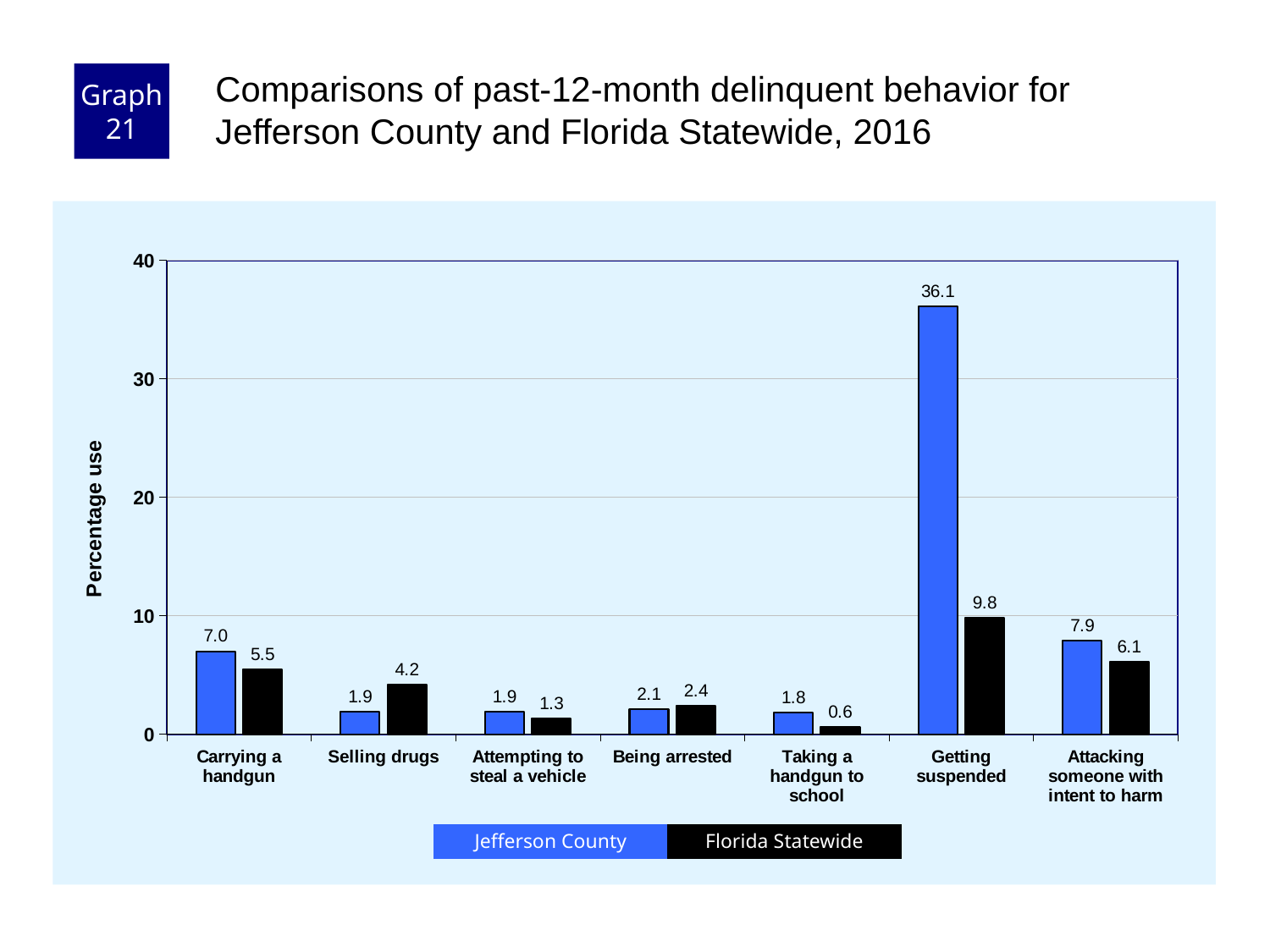
What is the Florida Statewide value for Taking a handgun to school? 0.6 What is the Jefferson County value for Getting suspended? 36.1 How many series does the legend list? 2 What is the Jefferson County value for Attacking someone with intent to harm? 7.9 How many categories are shown on the x axis? 7 Which category has the lowest Jefferson County value? Taking a handgun to school Which is larger for Selling drugs: the Jefferson County value or the Florida Statewide value? Florida Statewide What kind of chart is shown on the slide? bar chart Is the Jefferson County value for Getting suspended greater or less than 30? greater What is the difference between the Jefferson County and Florida Statewide values for Getting suspended? 26.3 Which category has the highest Florida Statewide value? Getting suspended What is the label of the y axis? Percentage use